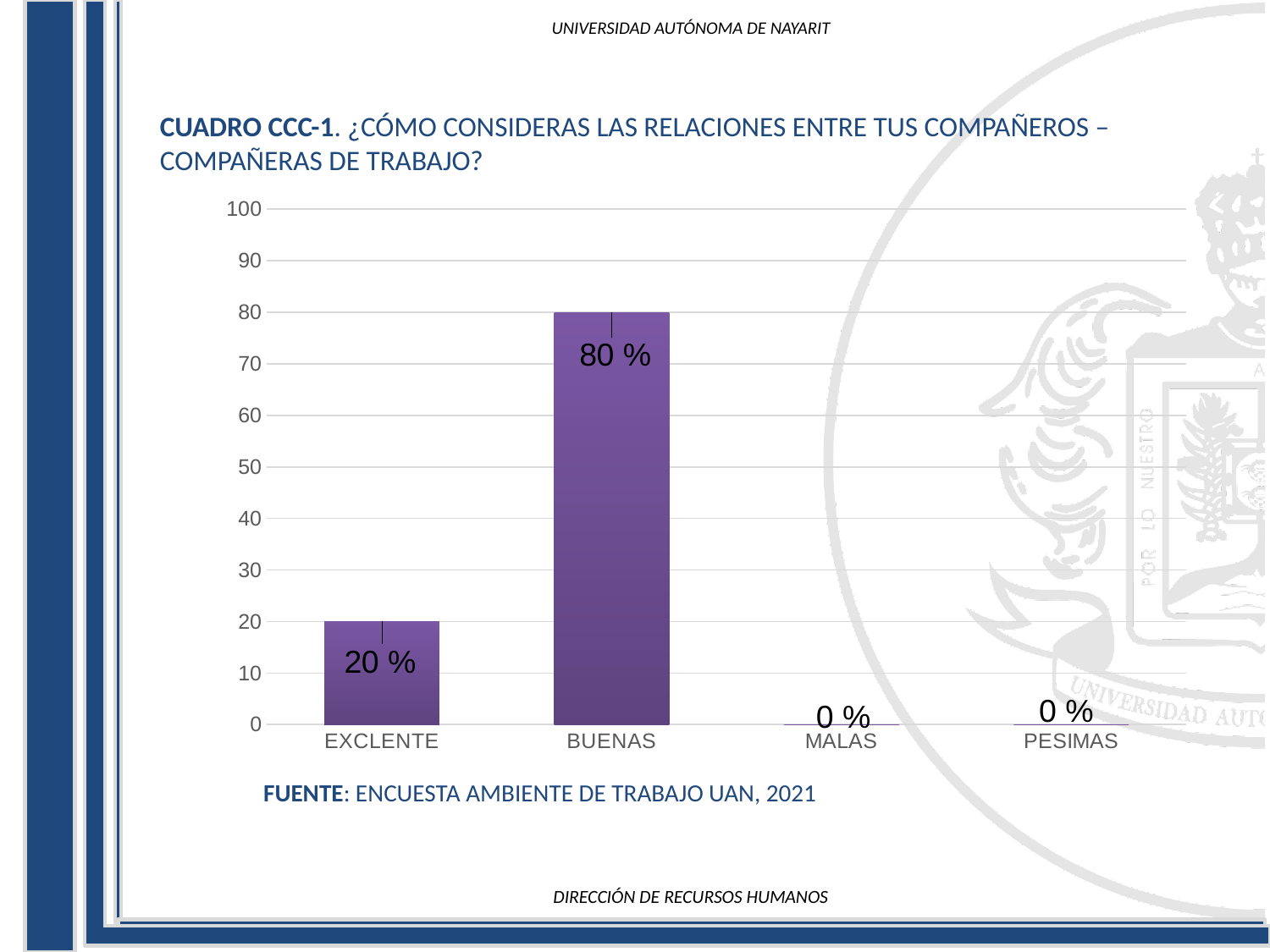
What is the value for MALAS? 0 % What kind of chart is shown on the slide? Bar chart Is the value for BUENAS greater or less than 50? greater What is the source cited below the chart? ENCUESTA AMBIENTE DE TRABAJO UAN, 2021 Is the value for EXCLENTE greater or less than 30? less Which is larger, the value for EXCLENTE or the value for BUENAS? BUENAS What is the value for PESIMAS? 0 % What is the difference between the values for BUENAS and EXCLENTE? 60 % How many categories are shown on the x axis? 4 What is the value for BUENAS? 80 % Which category has the highest value? BUENAS What is the value for EXCLENTE? 20 %